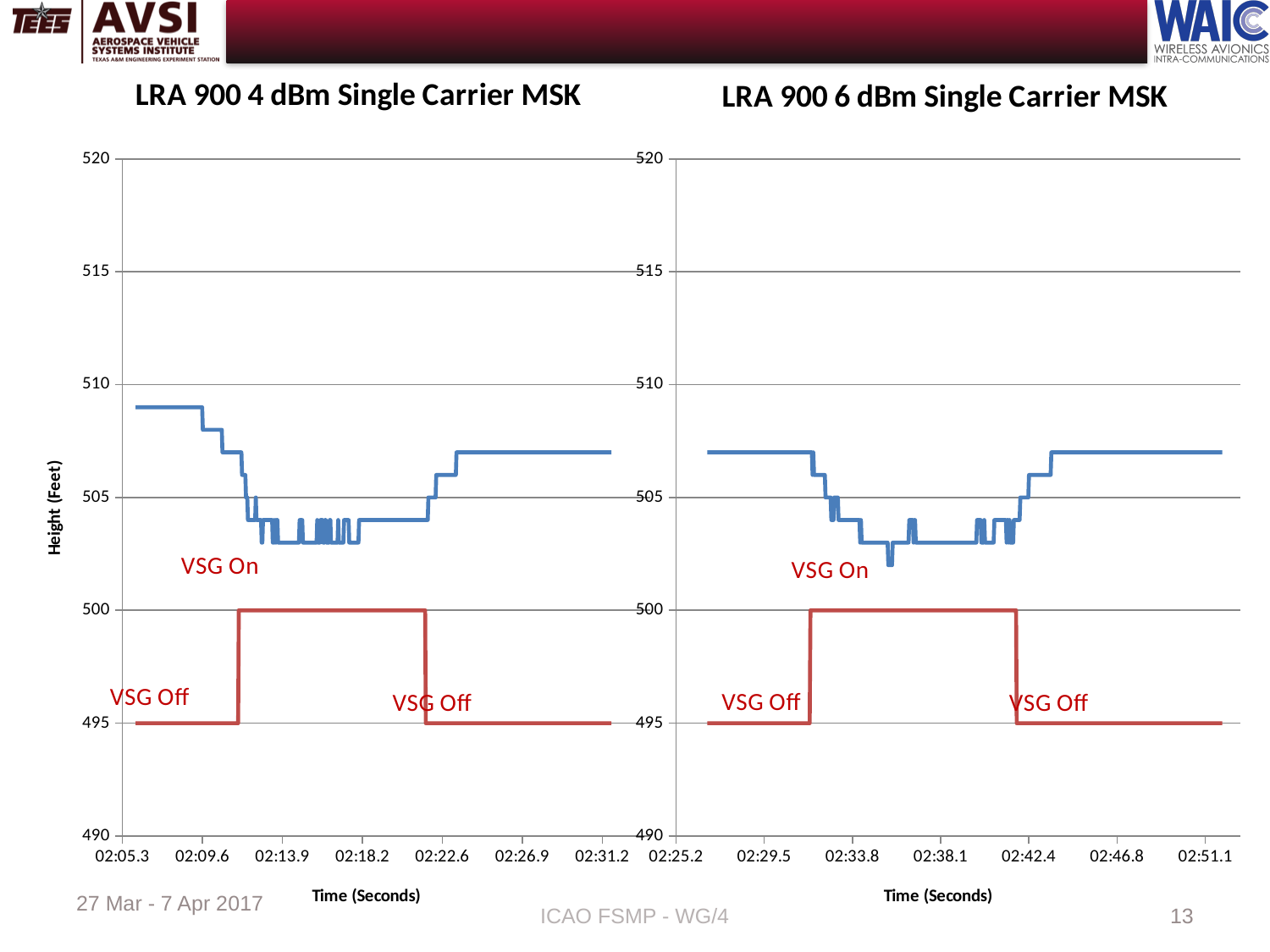
What is the y-axis title of the left chart? Height (Feet) In the right chart, is the lowest point of the blue height line greater or less than 505? less In the left chart, is the blue height line higher at the first time point (02:05.3) or at the last time point (02:31.2)? 02:05.3 In the right chart, what value does the red line sit at while VSG is off? 495 How many time labels are shown on the x axis of the left chart? 7 In the right chart, is the blue height line at the first time point (02:25.2) greater or less than 510? less What is the title of the right chart? LRA 900 6 dBm Single Carrier MSK In the left chart, does the blue height line rise or fall between 02:09.6 and 02:13.9? fall What is the last time label on the x axis of the right chart? 02:51.1 In the left chart, what value does the red line sit at while VSG is on? 500 What kind of chart is the left chart, 'LRA 900 4 dBm Single Carrier MSK'? line chart In the left chart, is the blue height line at the first time point (02:05.3) greater or less than 505? greater